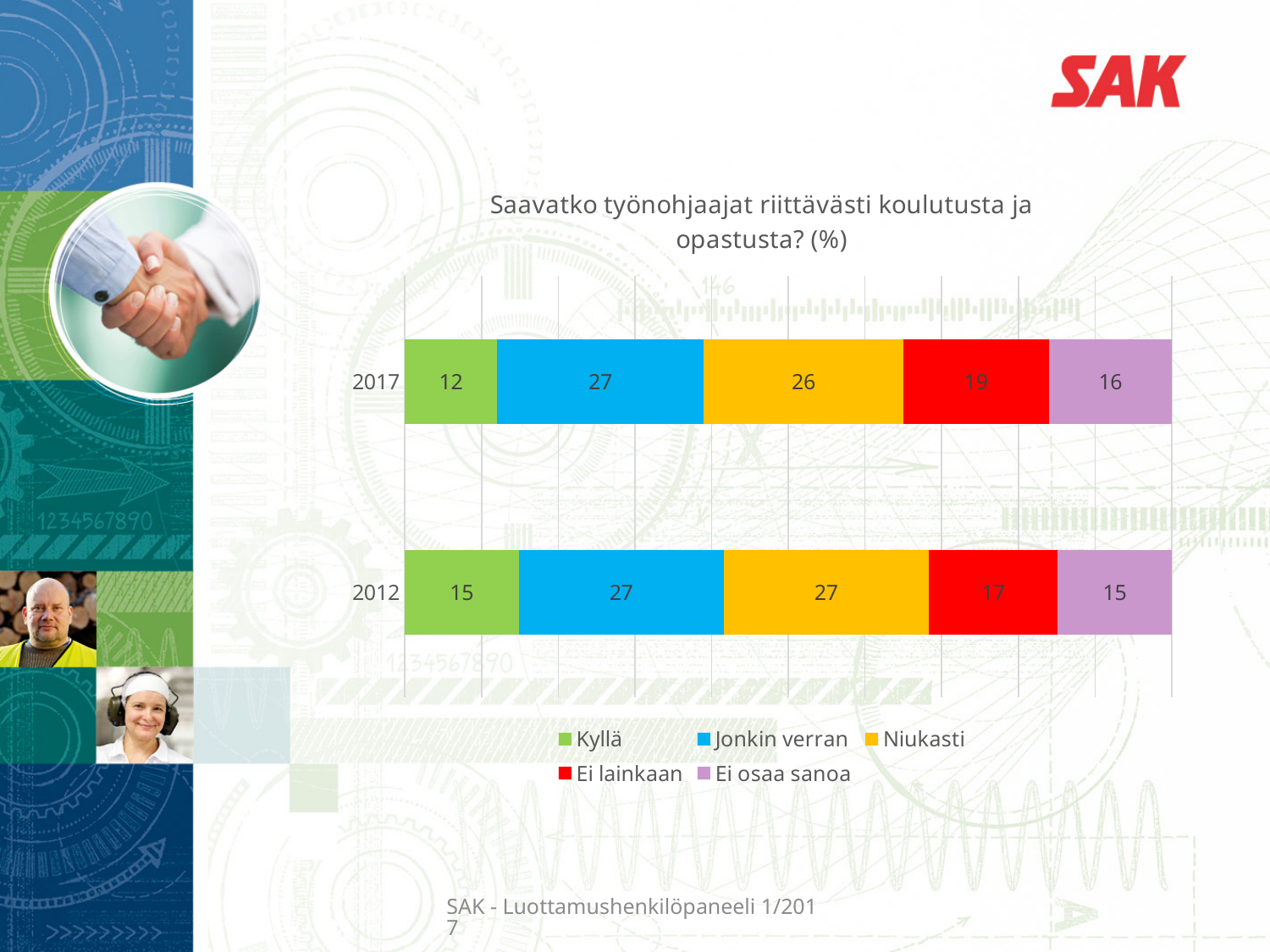
What is the total of the stacked bar for 2017? 100 What is the value for Ei osaa sanoa in 2017? 16 What is the value for Niukasti in 2012? 27 Which is larger: Ei lainkaan in 2017 or Ei lainkaan in 2012? Ei lainkaan in 2017 What is the title of the chart? Saavatko työnohjaajat riittävästi koulutusta ja opastusta? (%) How many years (categories) are shown in the chart? 2 What is the value for Kyllä in 2017? 12 What is the value for Ei lainkaan in 2012? 17 Which response category has the lowest value in 2017? Kyllä What kind of chart is shown on the slide? Stacked bar chart How many series does the legend list? 5 What is the difference between the Kyllä values for 2012 and 2017? 3